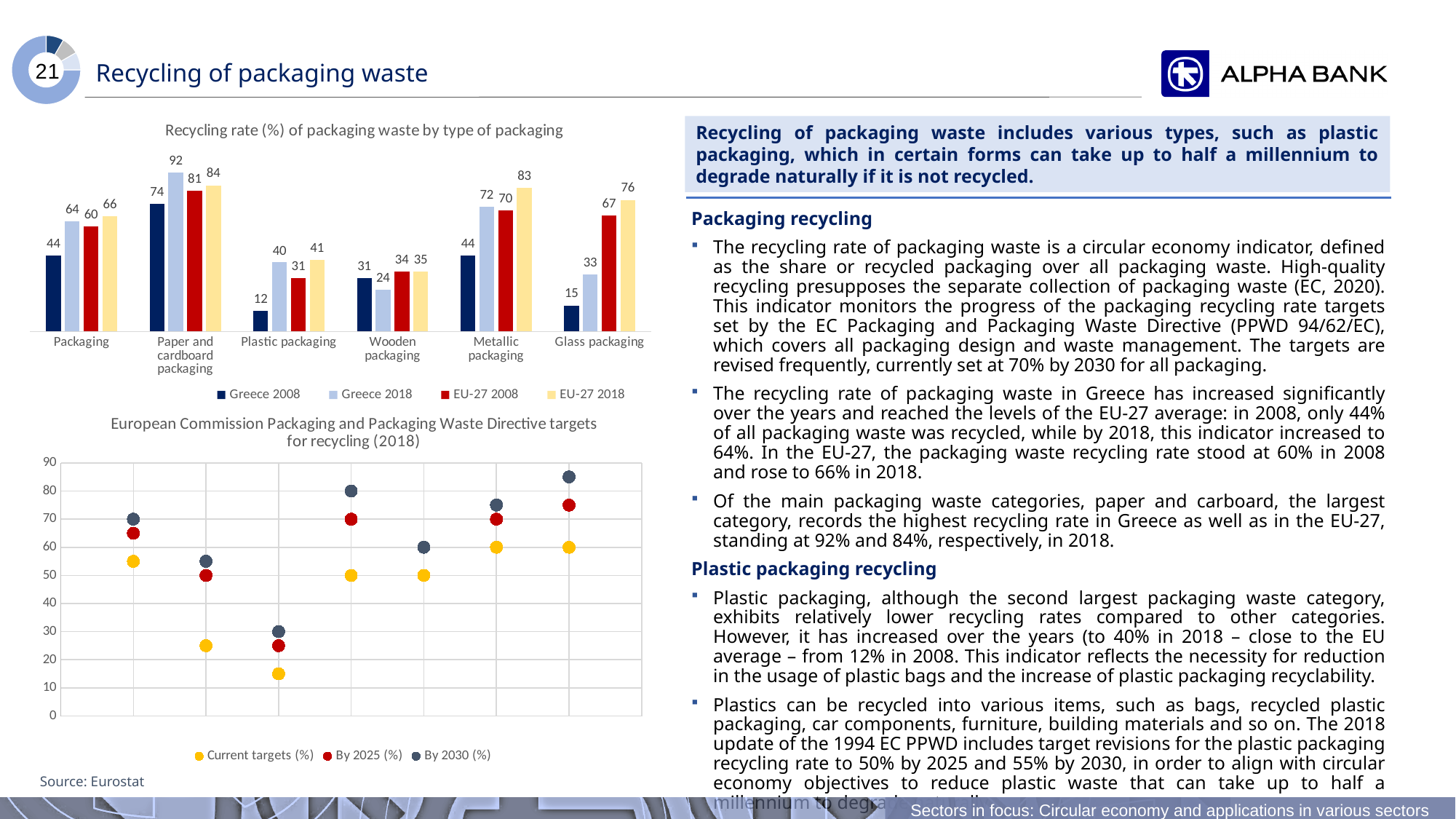
In the chart 'Recycling rate (%) of packaging waste by type of packaging', which category has the highest Greece 2018 value? Paper and cardboard packaging In the chart 'European Commission Packaging and Packaging Waste Directive targets for recycling (2018)', what colour are the 'By 2025 (%)' markers? Red In the chart 'European Commission Packaging and Packaging Waste Directive targets for recycling (2018)', how many series does the legend list? 3 In the chart 'European Commission Packaging and Packaging Waste Directive targets for recycling (2018)', how many points does the 'Current targets (%)' series have? 7 In the chart 'Recycling rate (%) of packaging waste by type of packaging', how many packaging categories are shown on the x axis? 6 In the chart 'Recycling rate (%) of packaging waste by type of packaging', which category has the lowest Greece 2008 value? Plastic packaging In the chart 'Recycling rate (%) of packaging waste by type of packaging', what is the difference between the Greece 2018 and Greece 2008 values for Metallic packaging? 28 In the chart 'Recycling rate (%) of packaging waste by type of packaging', what is the value for Greece 2018 for Plastic packaging? 40 What kind of chart is 'Recycling rate (%) of packaging waste by type of packaging'? Bar chart In the chart 'Recycling rate (%) of packaging waste by type of packaging', what is the value for EU-27 2008 for Glass packaging? 67 In the chart 'Recycling rate (%) of packaging waste by type of packaging', how many series does the legend list? 4 In the chart 'Recycling rate (%) of packaging waste by type of packaging', which is larger for Wooden packaging: Greece 2008 or Greece 2018? Greece 2008